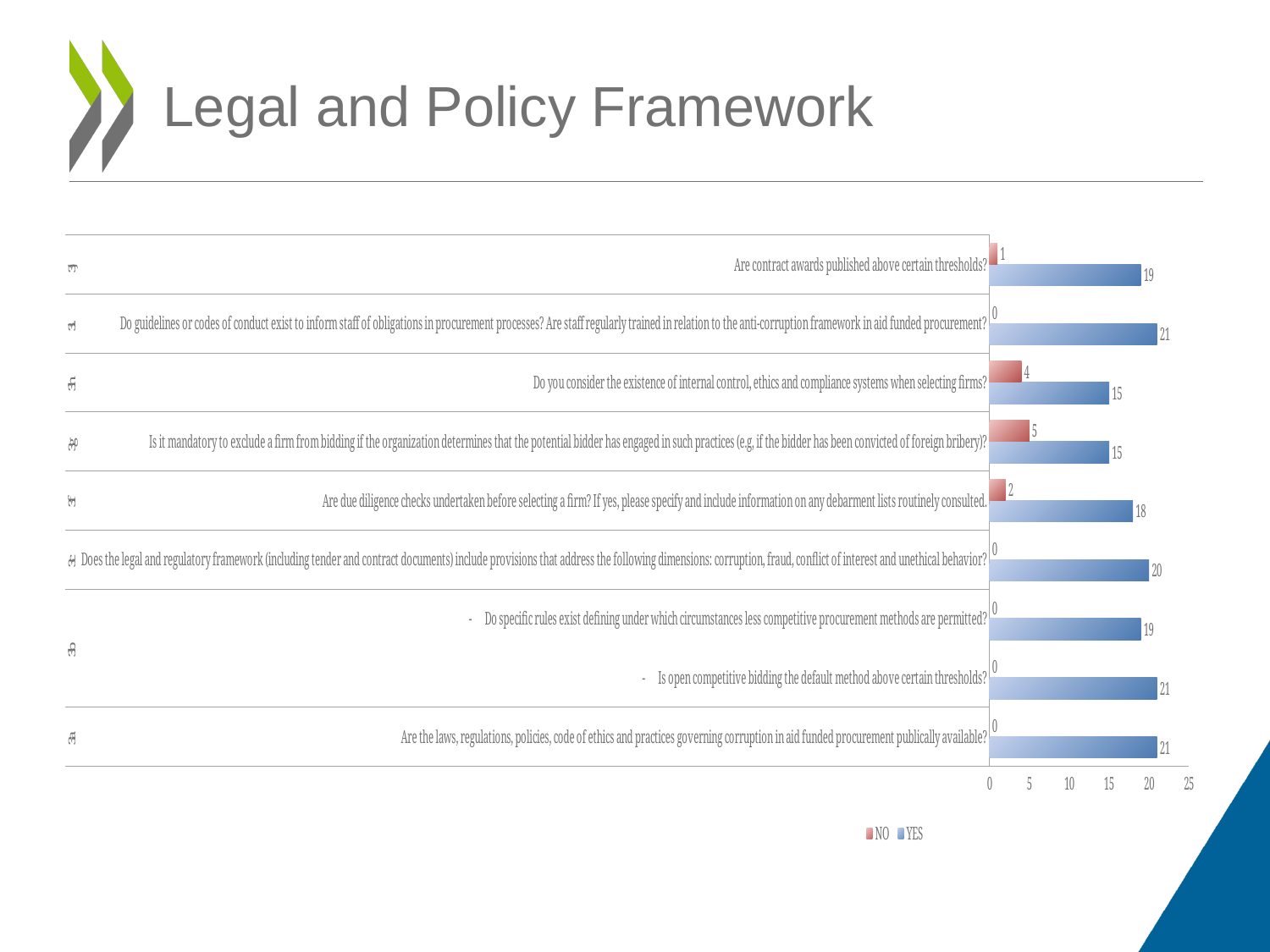
What is the difference between the YES and NO values for "Do you consider the existence of internal control, ethics and compliance systems when selecting firms?" 11 What is the NO value for "Are the laws, regulations, policies, code of ethics and practices governing corruption in aid funded procurement publically available?" 0 What is the lowest YES value shown in the chart? 15 How many question categories are plotted in the chart? 9 How many series does the legend list? 2 What type of chart is shown on the slide? bar chart Which colour represents the YES series in the chart? blue What is the NO value for "Is it mandatory to exclude a firm from bidding if the organization determines that the potential bidder has engaged in such practices"? 5 What is the YES value for "Are contract awards published above certain thresholds?" 19 Which is larger: the YES value for "Are contract awards published above certain thresholds?" or the YES value for "Is open competitive bidding the default method above certain thresholds?" Is open competitive bidding the default method above certain thresholds? What is the YES value for "Are due diligence checks undertaken before selecting a firm?" 18 Which question has the highest NO value? Is it mandatory to exclude a firm from bidding if the organization determines that the potential bidder has engaged in such practices